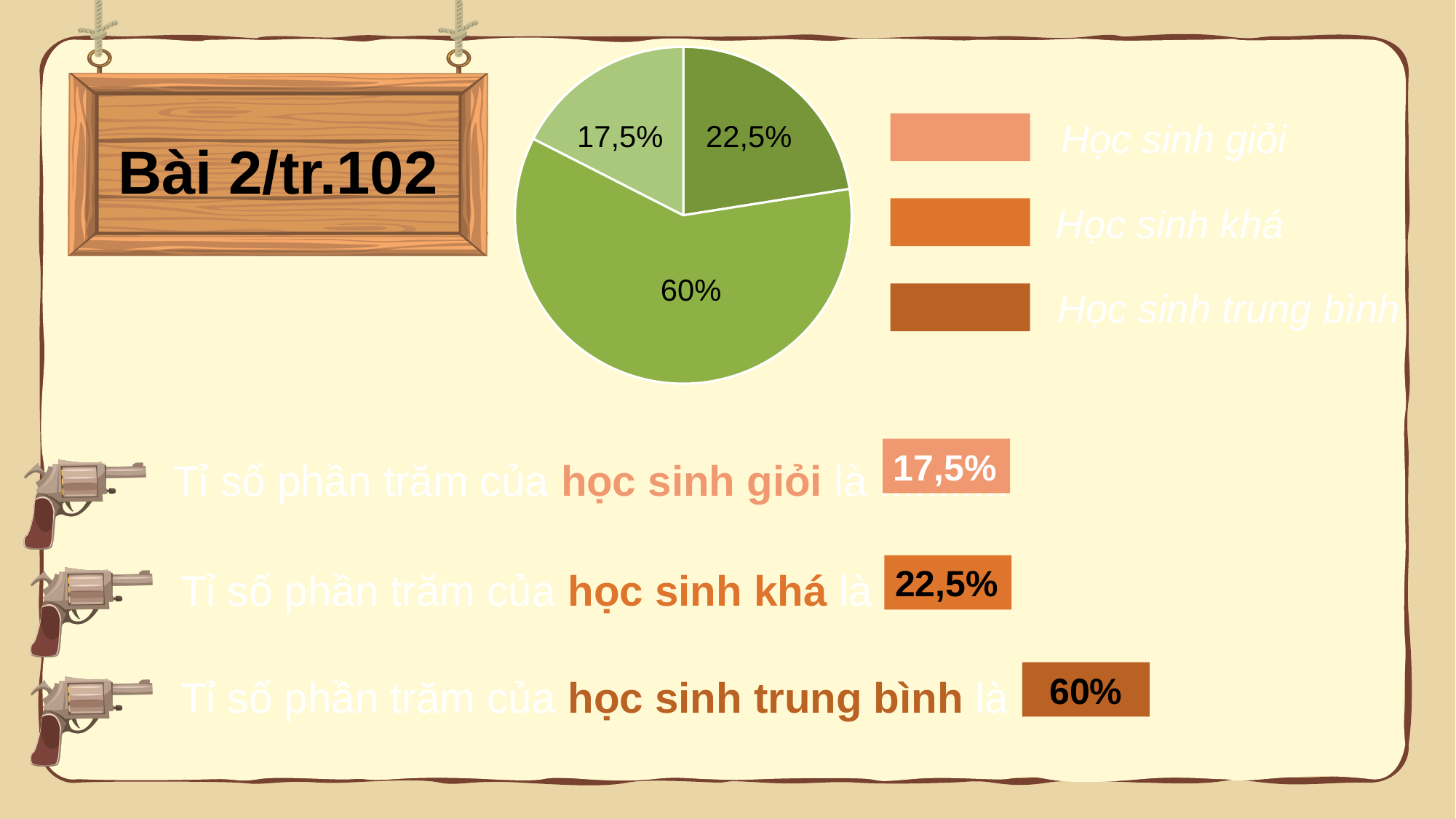
What is the difference between the share for học sinh trung bình and the share for học sinh khá? 37,5% Which category has the largest share of the pie? Học sinh trung bình What percentage is shown for học sinh khá? 22,5% What is the title shown on the wooden sign next to the chart? Bài 2/tr.102 How many entries does the legend list? 3 Which category has the smallest share of the pie? Học sinh giỏi What is the difference between the share for học sinh khá and the share for học sinh giỏi? 5% How many slices does the pie chart have? 3 Which is larger, the share for học sinh khá or the share for học sinh giỏi? Học sinh khá What percentage is shown for học sinh trung bình? 60% What percentage is shown for học sinh giỏi? 17,5% What kind of chart is shown on the slide? pie chart